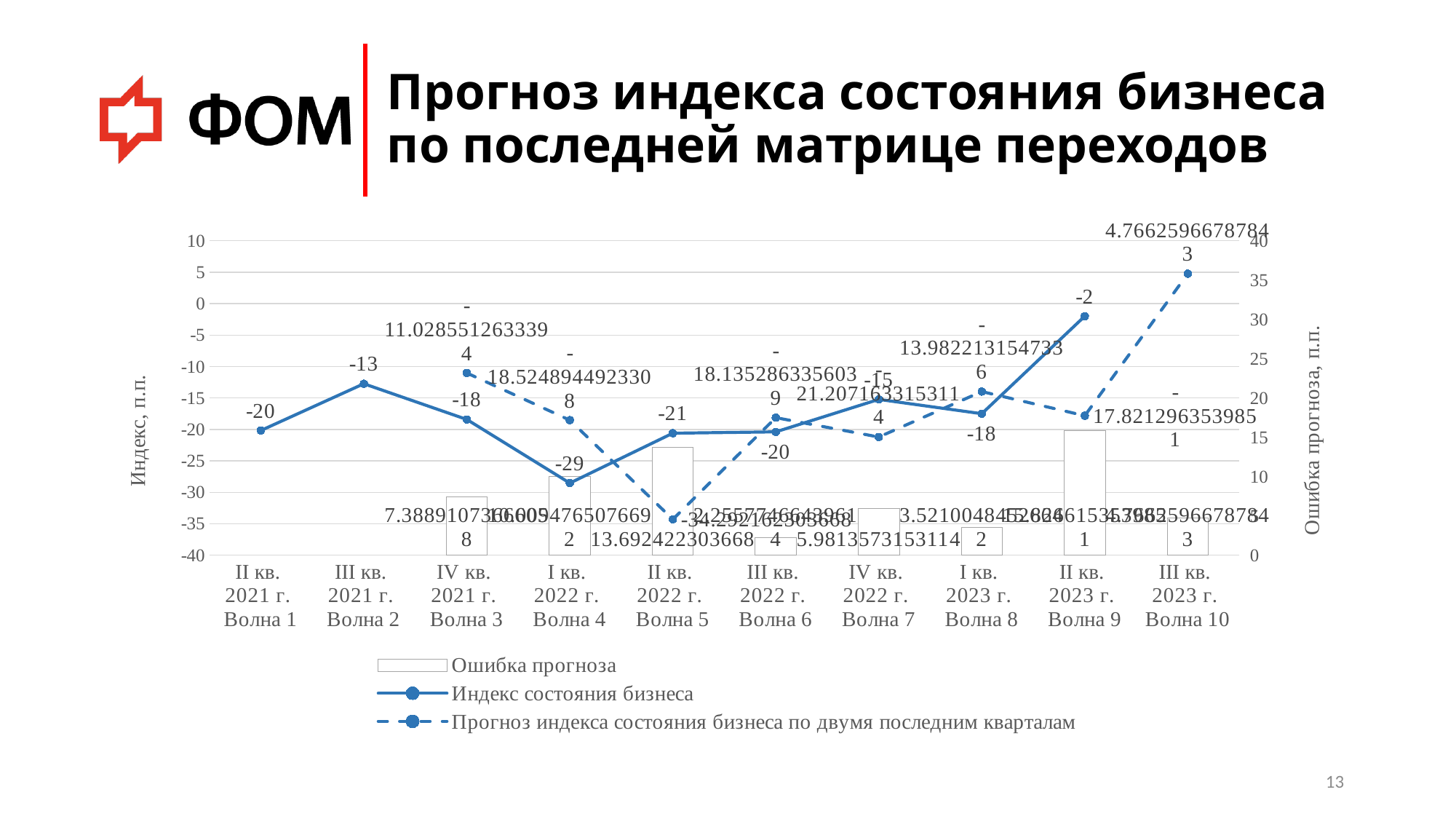
What is the value of 'Индекс состояния бизнеса' for I кв. 2022 г. Волна 4? -29 In which wave does 'Индекс состояния бизнеса' reach its lowest value? I кв. 2022 г. Волна 4 In which wave does 'Индекс состояния бизнеса' reach its highest value? II кв. 2023 г. Волна 9 How many series does the legend list? 3 What is the value of 'Индекс состояния бизнеса' for III кв. 2021 г. Волна 2? -13 Is the forecast value ('Прогноз индекса состояния бизнеса') for III кв. 2023 г. Волна 10 greater or less than 0 on the left axis? greater What is the title of the right-hand vertical axis? Ошибка прогноза, п.п. What is the value of 'Индекс состояния бизнеса' for II кв. 2023 г. Волна 9? -2 What is the difference between 'Индекс состояния бизнеса' in Волна 9 and in Волна 4? 27 What kind of chart is shown on the slide? A combined line and bar chart Which is higher, 'Индекс состояния бизнеса' in Волна 2 or in Волна 3? Волна 2 How many waves (categories) are shown on the x axis? 10